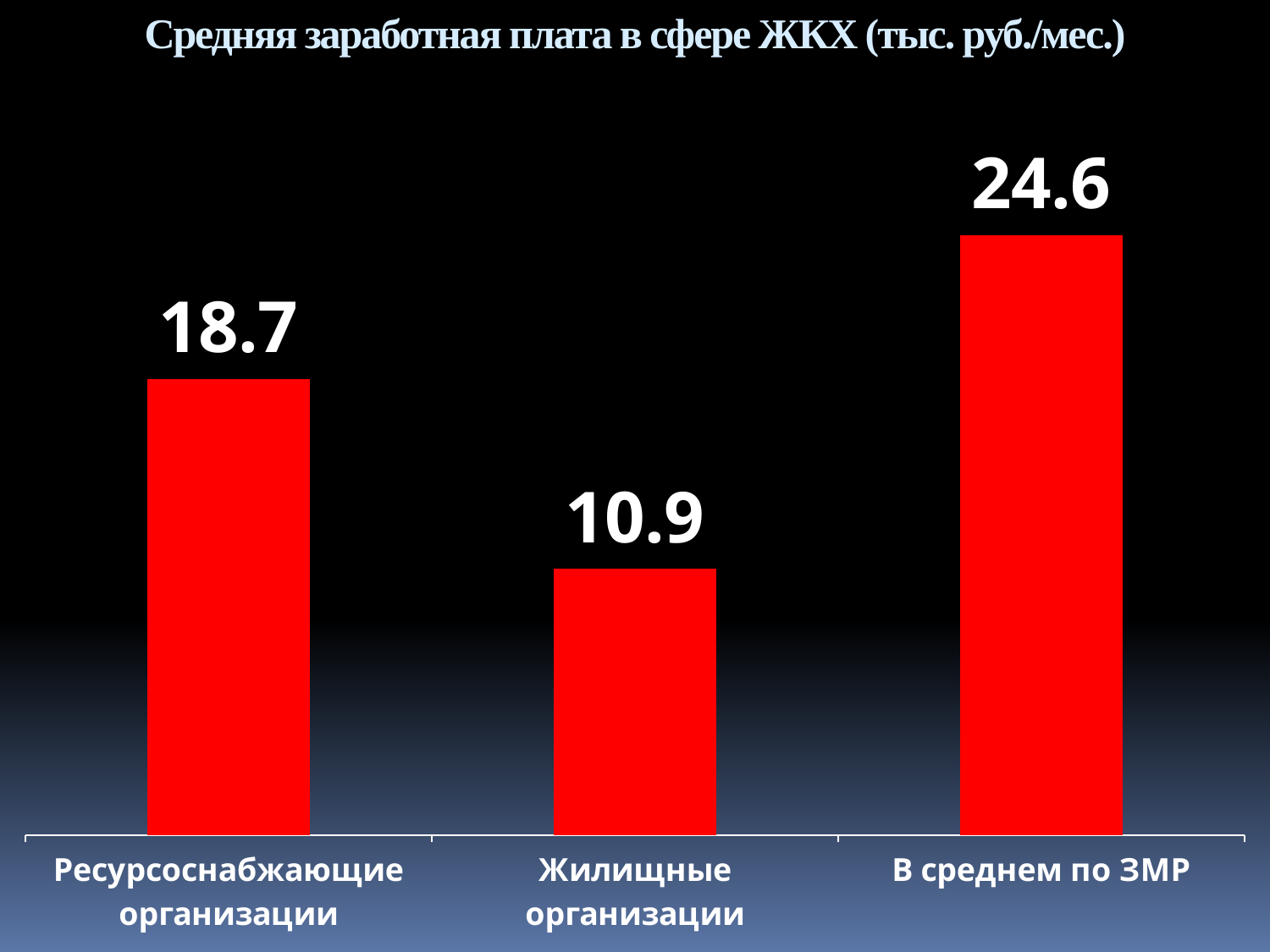
What is the value for Ресурсоснабжающие организации? 18.7 Which is larger, the value for Ресурсоснабжающие организации or the value for Жилищные организации? Ресурсоснабжающие организации What is the difference between the values for Ресурсоснабжающие организации and Жилищные организации? 7.8 What is the title of the chart? Средняя заработная плата в сфере ЖКХ (тыс. руб./мес.) What is the value for Жилищные организации? 10.9 What is the difference between the values for В среднем по ЗМР and Ресурсоснабжающие организации? 5.9 What colour are the bars in the chart? Red What is the value for В среднем по ЗМР? 24.6 Which category has the lowest value? Жилищные организации What kind of chart is shown on the slide? Bar chart Which category has the highest value? В среднем по ЗМР How many categories are shown in the chart? 3